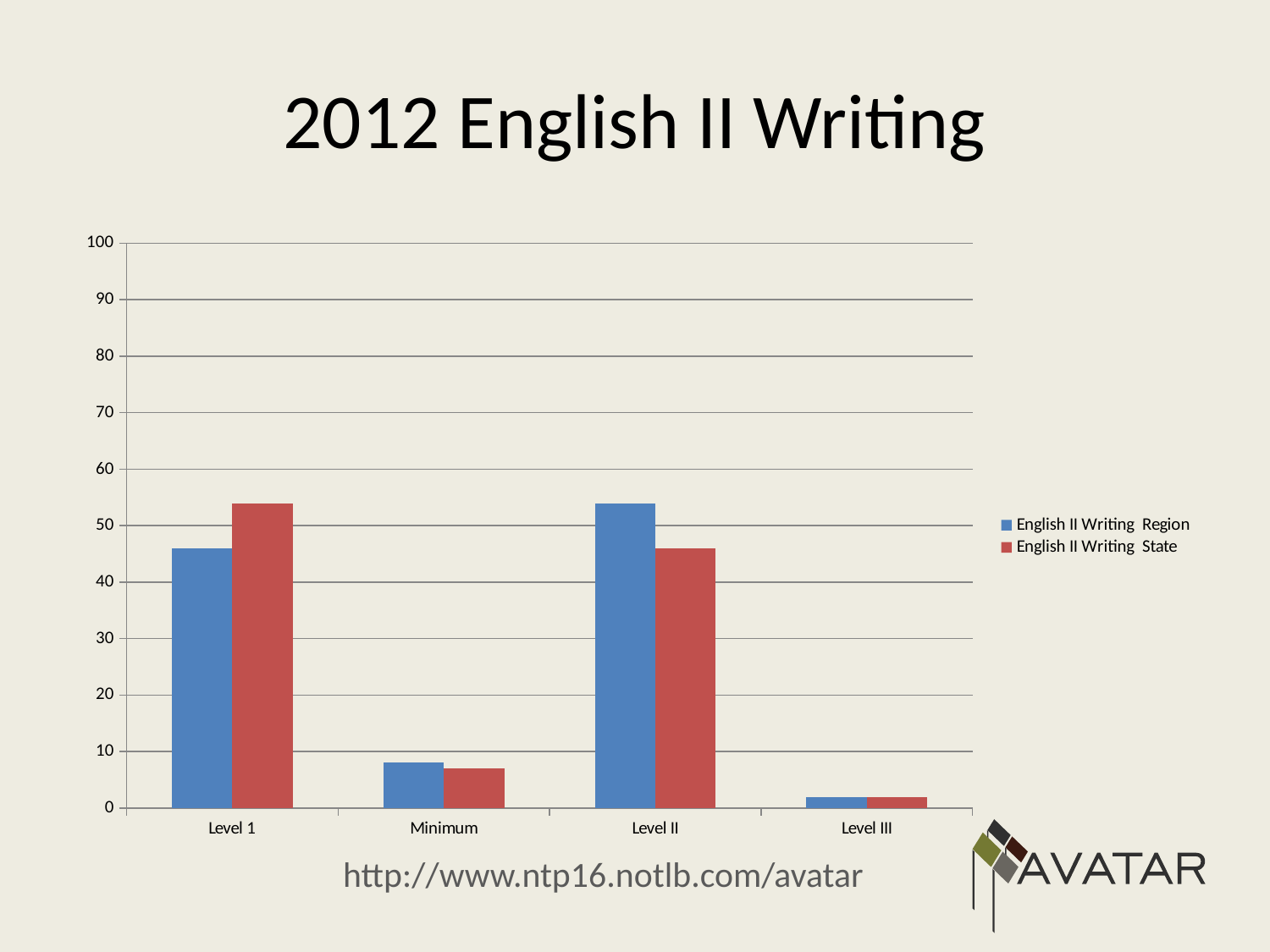
How many categories are shown on the x axis? 4 Which category has the lowest value for English II Writing Region? Level III Which category has the highest value for English II Writing Region? Level II What kind of chart is shown on the slide? bar chart For Level II, which is larger: English II Writing Region or English II Writing State? English II Writing Region Which category has the highest value for English II Writing State? Level 1 Is the value for English II Writing State at Level 1 greater or less than 50? greater Which category has the lowest value for English II Writing State? Level III Is the value for English II Writing Region at Level 1 greater or less than 50? less How many series does the legend list? 2 For Level 1, which is larger: English II Writing Region or English II Writing State? English II Writing State What is the title of the chart? 2012 English II Writing